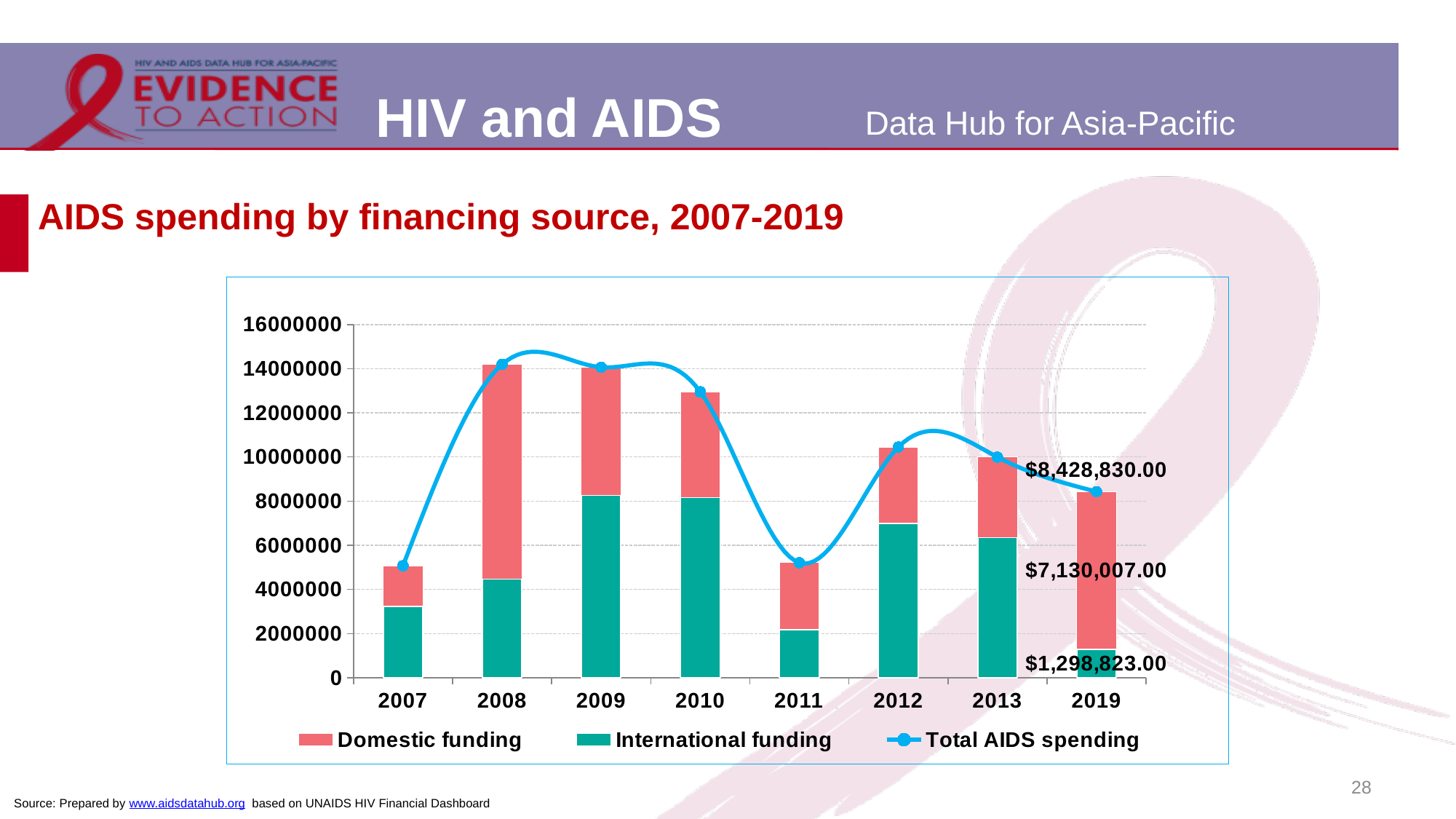
Does total AIDS spending rise or fall from 2010 to 2011? fall How many series does the legend list? 3 Which year has the highest domestic funding? 2008 What is the international funding value shown for 2019? $1,298,823.00 What is the domestic funding value shown for 2019? $7,130,007.00 What is the total AIDS spending shown for 2019? $8,428,830.00 How many years are shown on the x axis? 8 Which year has the larger total AIDS spending, 2011 or 2012? 2012 In 2019, how much larger is domestic funding than international funding? $5,831,184.00 Is the total AIDS spending for 2011 greater or less than 6000000? less Which year has the lowest international funding? 2019 Is the total AIDS spending for 2013 greater or less than 12000000? less